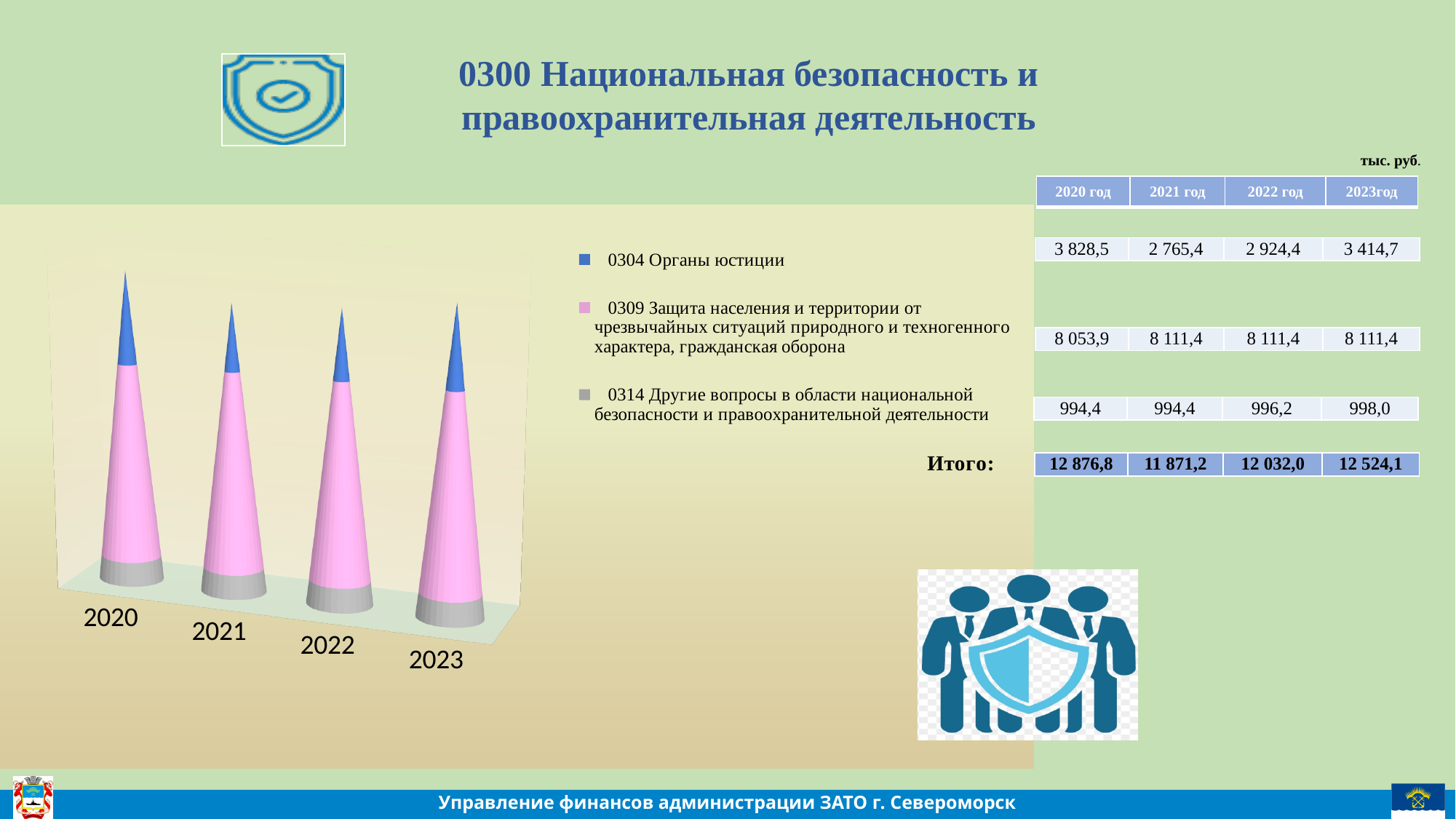
Does the value for 0304 Органы юстиции rise or fall from 2021 to 2023? Rises Which is larger: the 0304 Органы юстиции value for 2022 or for 2023? 2023 What is the difference between the 0304 Органы юстиции values for 2020 and 2021? 1 063,1 What is the total (Итого) for 2021? 11 871,2 What kind of chart is shown on the slide? Stacked bar chart What is the value for 0309 Защита населения и территории от чрезвычайных ситуаций in 2023? 8 111,4 What is the value for 0304 Органы юстиции in 2020? 3 828,5 How many years (categories) are shown along the x axis of the chart? 4 Which year has the lowest total (Итого)? 2021 Which year has the highest total (Итого)? 2020 What is the value for 0314 Другие вопросы в области национальной безопасности in 2022? 996,2 How many series does the chart legend list? 3